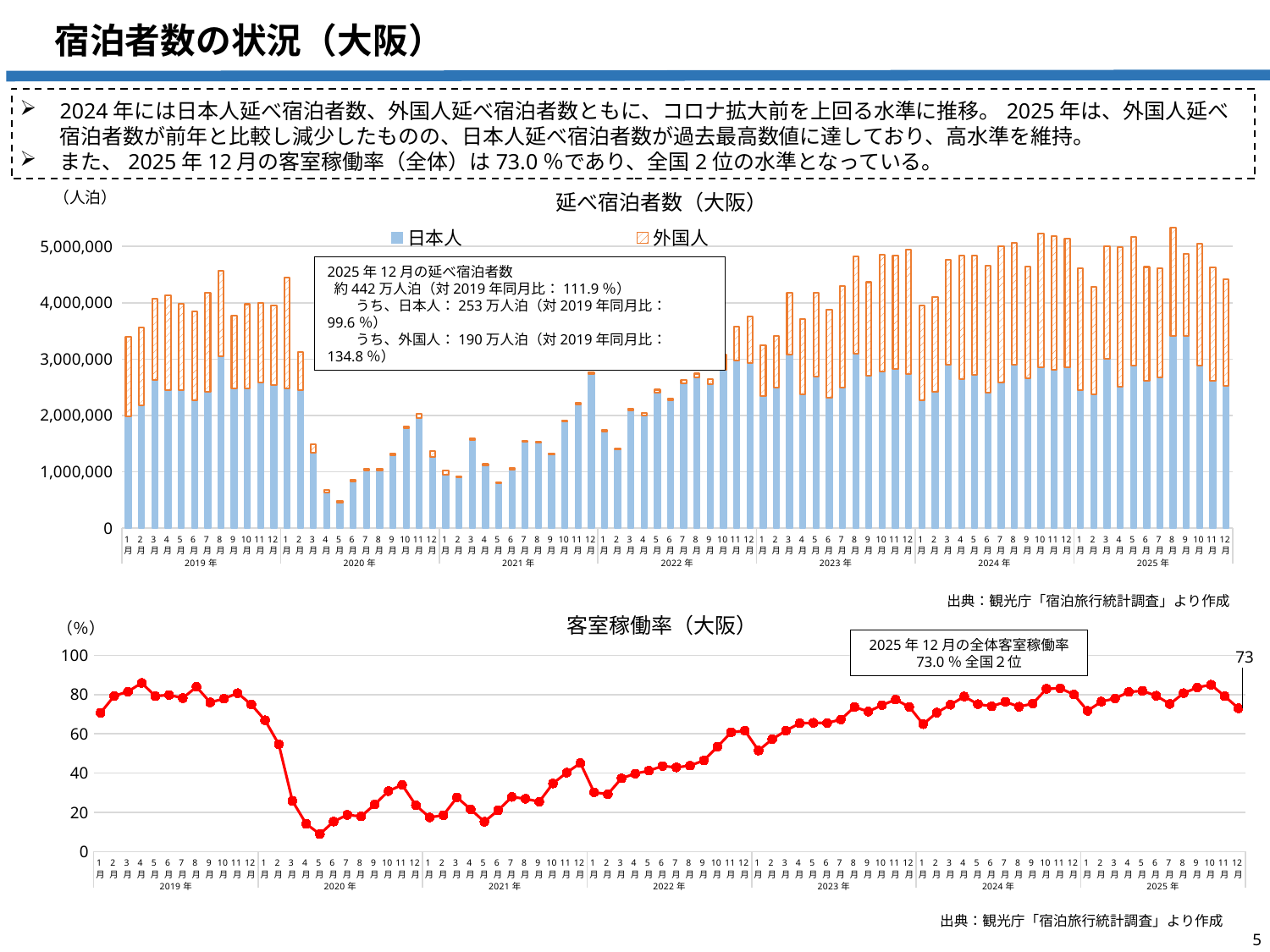
In the lower chart 客室稼働率（大阪）, which is larger, the value for 2019年4月 or the value for 2020年4月? 2019年4月 In the lower chart 客室稼働率（大阪）, what is the value for 2025年12月? 73 In the upper chart 延べ宿泊者数（大阪）, which month has the lowest total stacked bar? 2020年5月 What kind of chart is the upper chart 延べ宿泊者数（大阪）? stacked bar chart In the upper chart 延べ宿泊者数（大阪）, what are the two legend entries? 日本人, 外国人 What kind of chart is the lower chart 客室稼働率（大阪）? line chart In the lower chart 客室稼働率（大阪）, is the value for 2020年5月 greater or less than 20? less In the lower chart 客室稼働率（大阪）, do the values rise or fall from 2020年1月 to 2020年5月? fall What is the title of the upper chart on the slide? 延べ宿泊者数（大阪） In the lower chart 客室稼働率（大阪）, which month has the lowest occupancy rate? 2020年5月 In the upper chart 延べ宿泊者数（大阪）, how many series does the legend list? 2 In the upper chart 延べ宿泊者数（大阪）, is the total for 2019年1月 greater or less than 3,000,000? greater